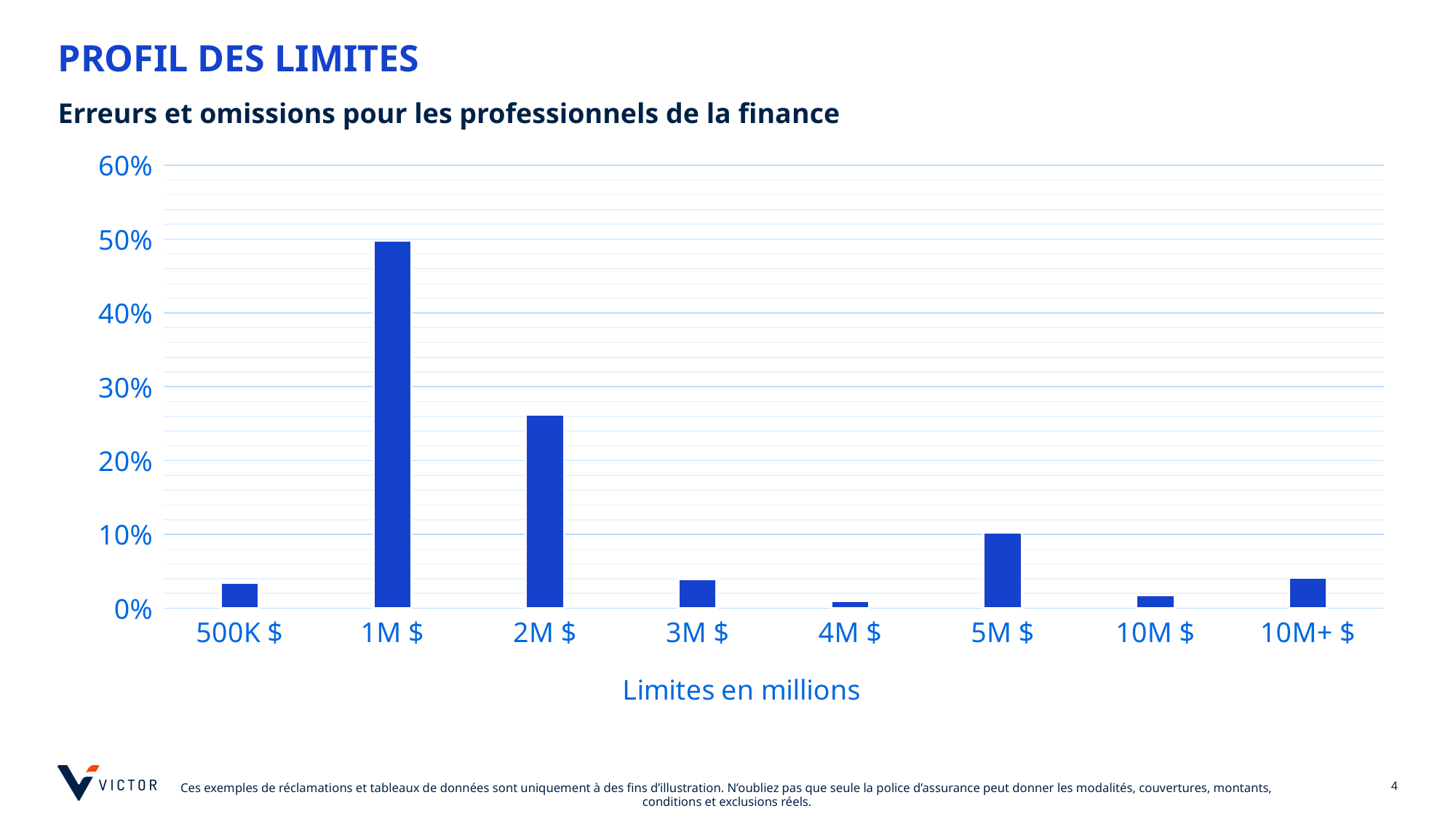
Which limit category has the highest percentage? 1M $ Is the value for 2M $ greater or less than 30%? less Which is larger, the value for 3M $ or the value for 4M $? 3M $ Which is larger, the value for 2M $ or the value for 5M $? 2M $ Is the value for 2M $ greater or less than 20%? greater How many limit categories are shown on the x axis? 8 What is the title of the x axis? Limites en millions Is the value for 1M $ greater or less than 40%? greater Which limit category has the lowest percentage? 4M $ Do the values rise or fall along the x axis from 1M $ to 4M $? fall What kind of chart is shown on the slide? bar chart